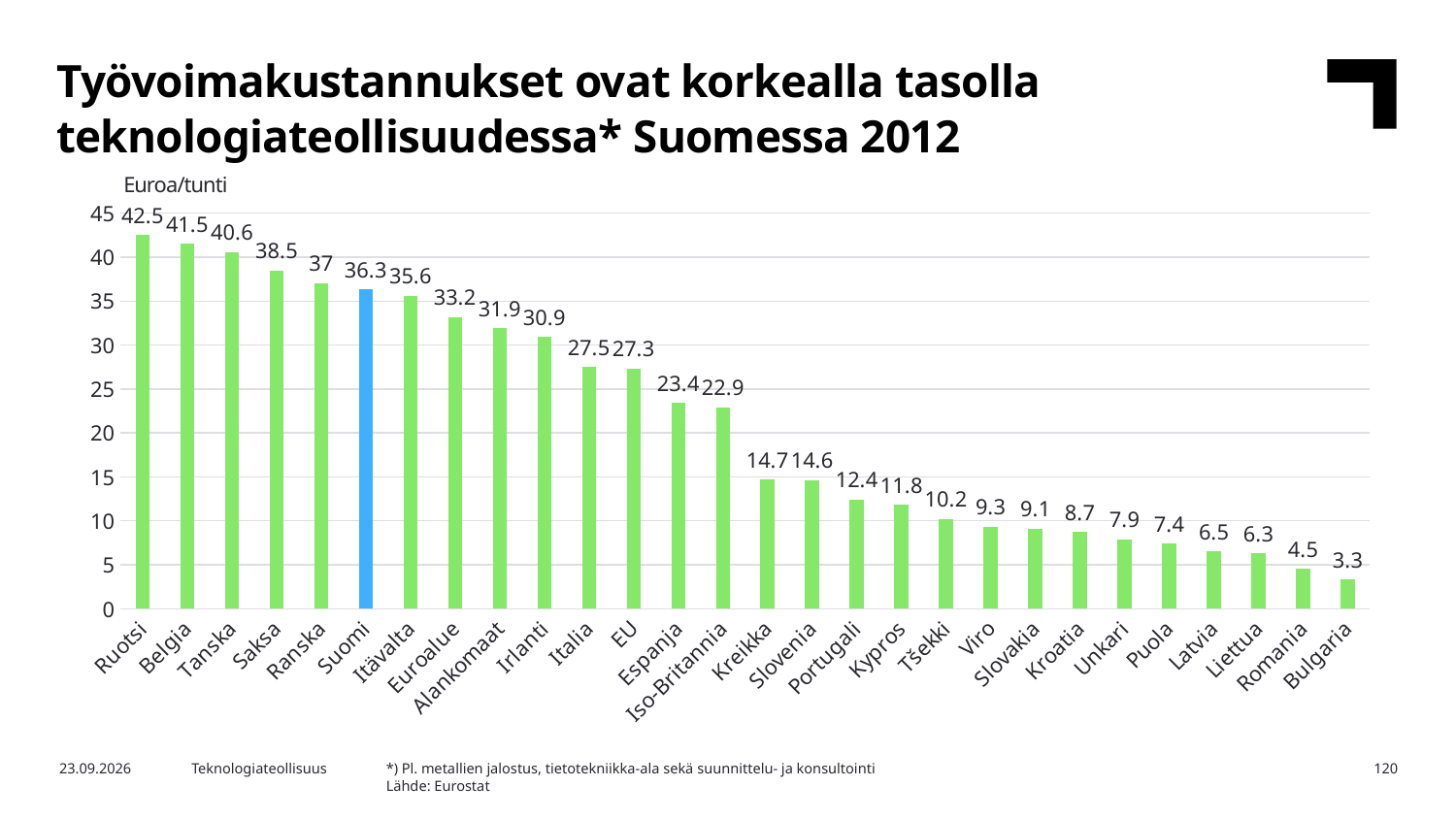
Which is larger, the value for Espanja or the value for Kreikka? Espanja What is the value for Suomi? 36.3 Which bar is coloured differently (blue) from the others? Suomi Do the values rise or fall from left to right along the x axis? Fall What is the value for Bulgaria? 3.3 How many countries or regions are shown on the chart? 28 Which country has the highest labour cost per hour? Ruotsi Which country has the lowest labour cost per hour? Bulgaria What is the value for Saksa? 38.5 What is the value for EU? 27.3 What is the difference between the values for Ruotsi and Suomi? 6.2 What kind of chart is shown on the slide? Bar chart